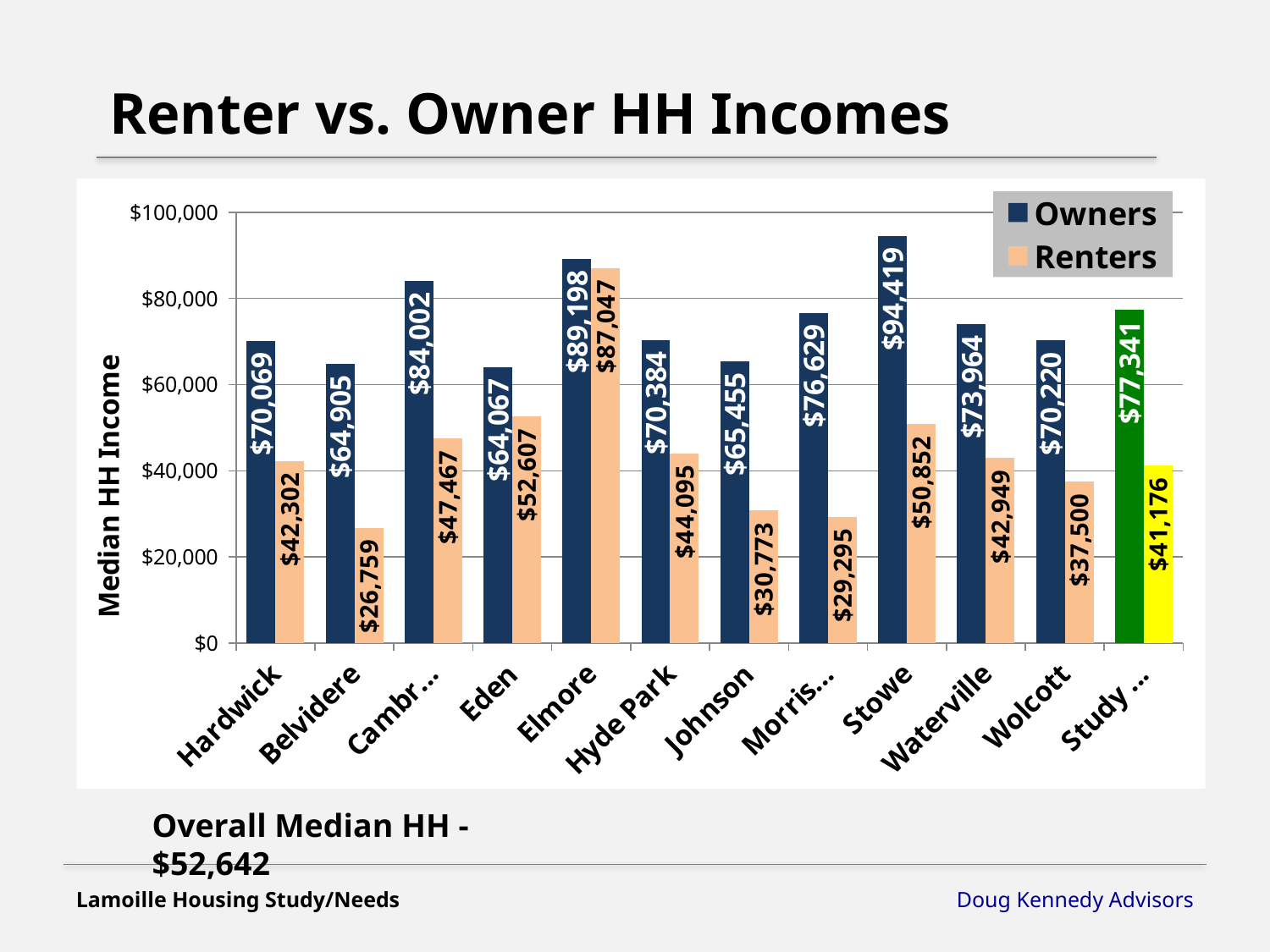
What is the Renters value for Eden? $52,607 What is the Owners value for Hardwick? $70,069 Is the Owners value for Stowe greater or less than $80,000? greater Which is larger, the Renters value for Hyde Park or the Renters value for Waterville? Hyde Park How many categories are shown on the x axis? 12 What is the difference between the Owners and Renters values for Elmore? $2,151 How many series does the legend list? 2 Which town has the lowest Renters median HH income? Belvidere What kind of chart is shown on the slide? bar chart What is the Renters value for Wolcott? $37,500 Which town has the highest Owners median HH income? Stowe What is the difference between the Owners and Renters values for Stowe? $43,567